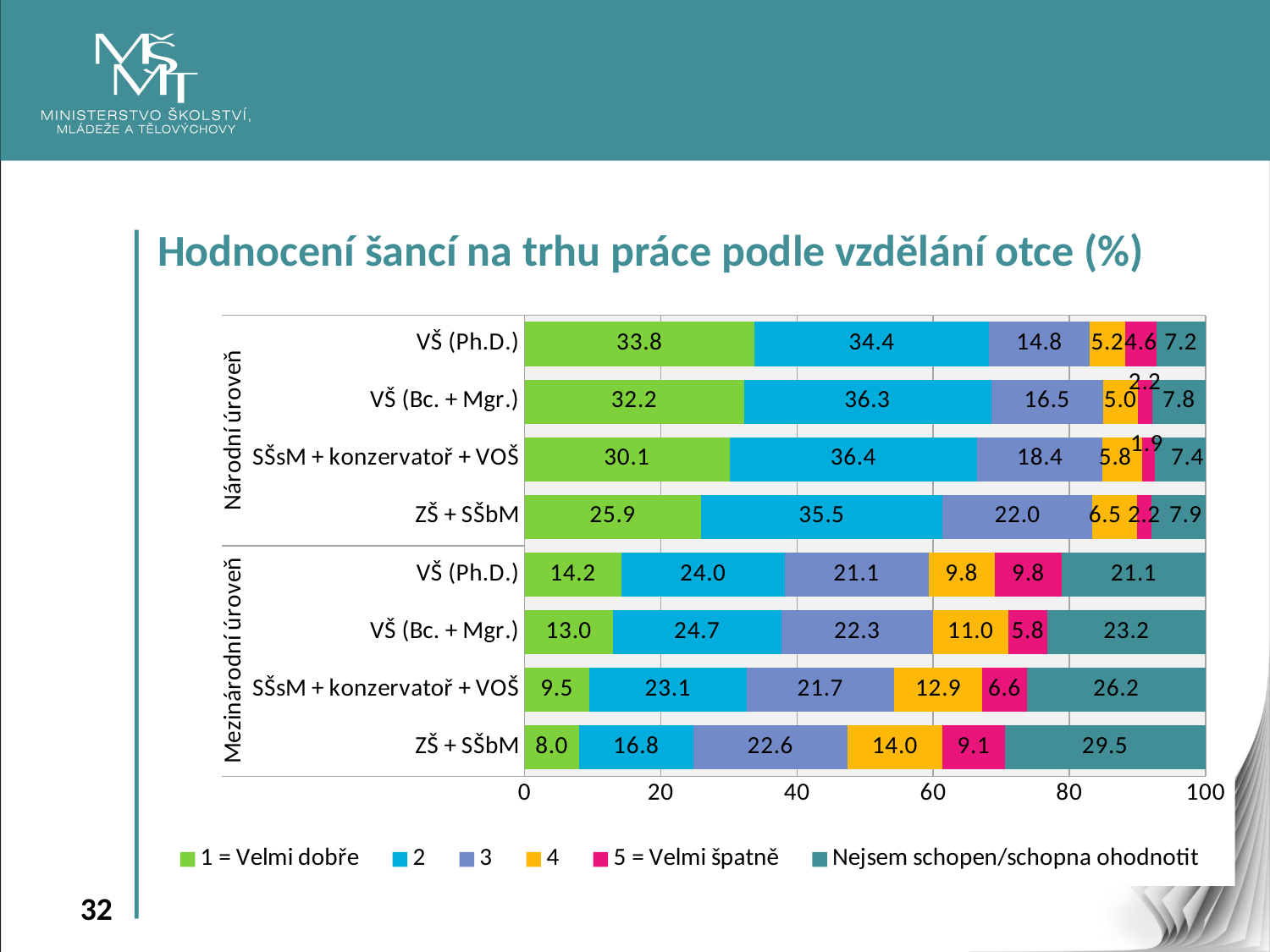
At the Mezinárodní úroveň level, which is larger: the "5 = Velmi špatně" value for VŠ (Ph.D.) or for VŠ (Bc. + Mgr.)? VŠ (Ph.D.) What is the value of series "4" for VŠ (Bc. + Mgr.) at the Mezinárodní úroveň level? 11.0 What is the value of "1 = Velmi dobře" for VŠ (Ph.D.) at the Národní úroveň level? 33.8 What is the value of series "2" for SŠsM + konzervatoř + VOŠ at the Národní úroveň level? 36.4 What is the title of the chart? Hodnocení šancí na trhu práce podle vzdělání otce (%) How many bars (categories) are plotted in the chart? 8 How many series does the legend list? 6 Which category at the Národní úroveň level has the highest value for "1 = Velmi dobře"? VŠ (Ph.D.) What kind of chart is shown on the slide? Stacked bar chart What is the value of "Nejsem schopen/schopna ohodnotit" for ZŠ + SŠbM at the Mezinárodní úroveň level? 29.5 Which category at the Mezinárodní úroveň level has the lowest value for "1 = Velmi dobře"? ZŠ + SŠbM What is the difference between the "1 = Velmi dobře" values for VŠ (Ph.D.) and ZŠ + SŠbM at the Národní úroveň level? 7.9